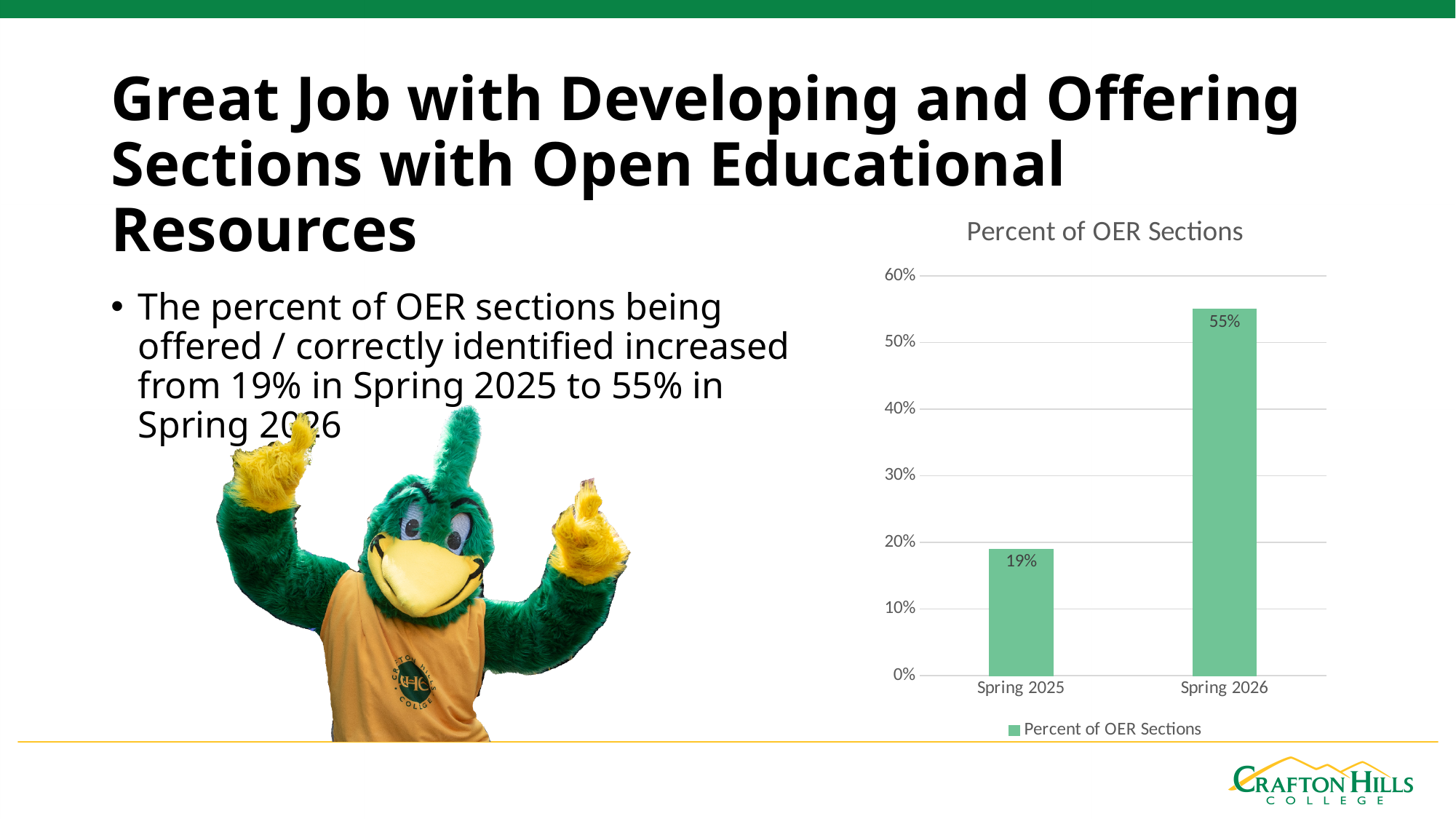
Is the percent of OER sections for Spring 2026 greater or less than 50%? greater Is the percent of OER sections for Spring 2025 greater or less than 20%? less Which term has the higher percent of OER sections? Spring 2026 How many series does the chart legend list? 1 What is the percent of OER sections for Spring 2025? 19% How many terms are shown on the x axis of the chart? 2 Which term has the lower percent of OER sections? Spring 2025 What type of chart is shown on the slide? Bar chart What is the percent of OER sections for Spring 2026? 55% By how many percentage points did the percent of OER sections increase from Spring 2025 to Spring 2026? 36 percentage points Does the percent of OER sections rise or fall from Spring 2025 to Spring 2026? Rise What is the title of the chart? Percent of OER Sections